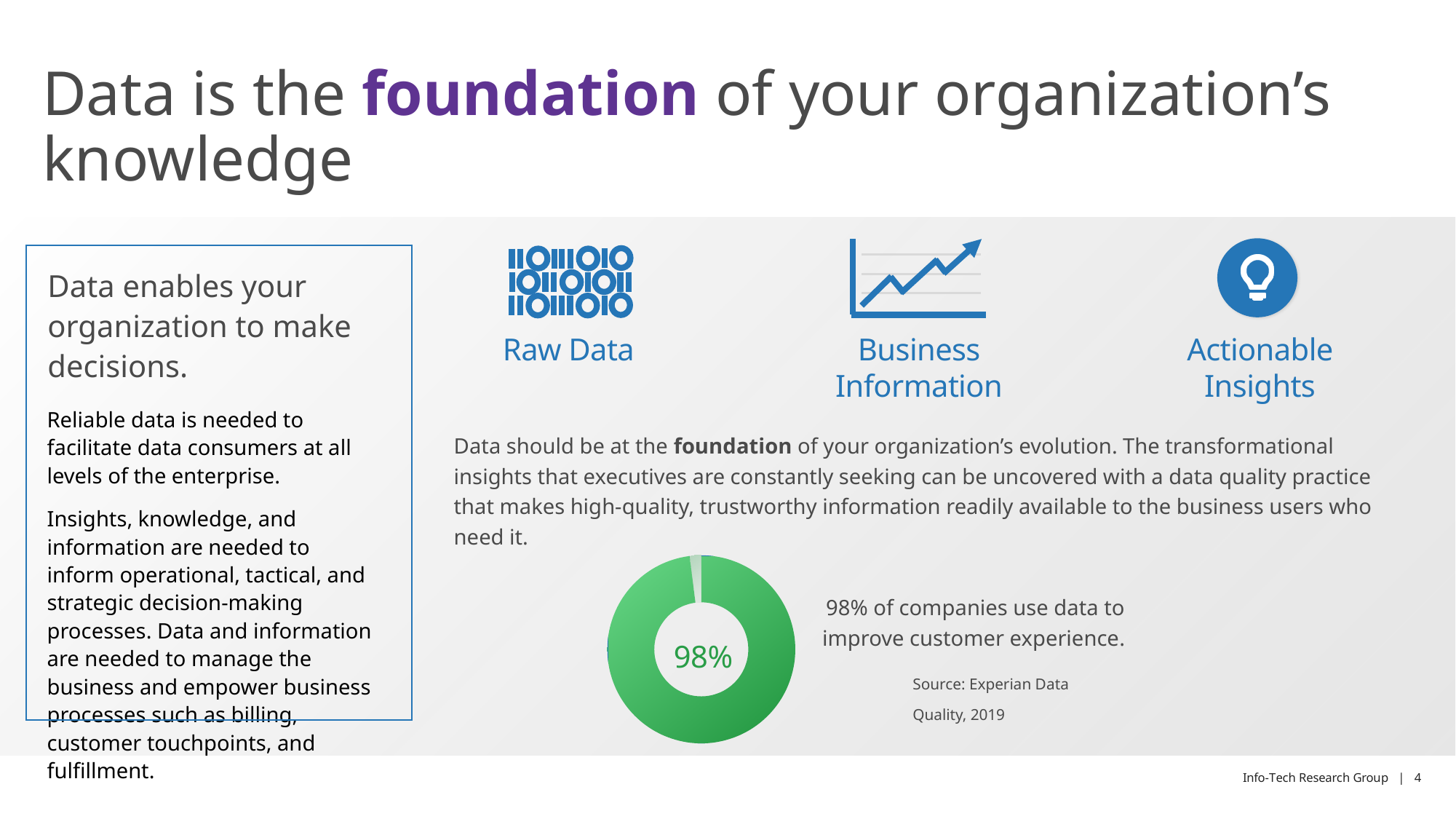
What value is printed in the centre of the donut chart? 98% What does the 98% in the donut chart represent? companies that use data to improve customer experience Which slice of the donut chart is larger, the green one or the grey one? the green one What kind of chart is shown at the bottom of the slide? donut chart What source is cited for the donut chart's statistic? Experian Data Quality, 2019 What colour is the slice representing 98% in the donut chart? green According to the donut chart, what share of companies use data to improve customer experience? 98% How many slices does the donut chart have? 2